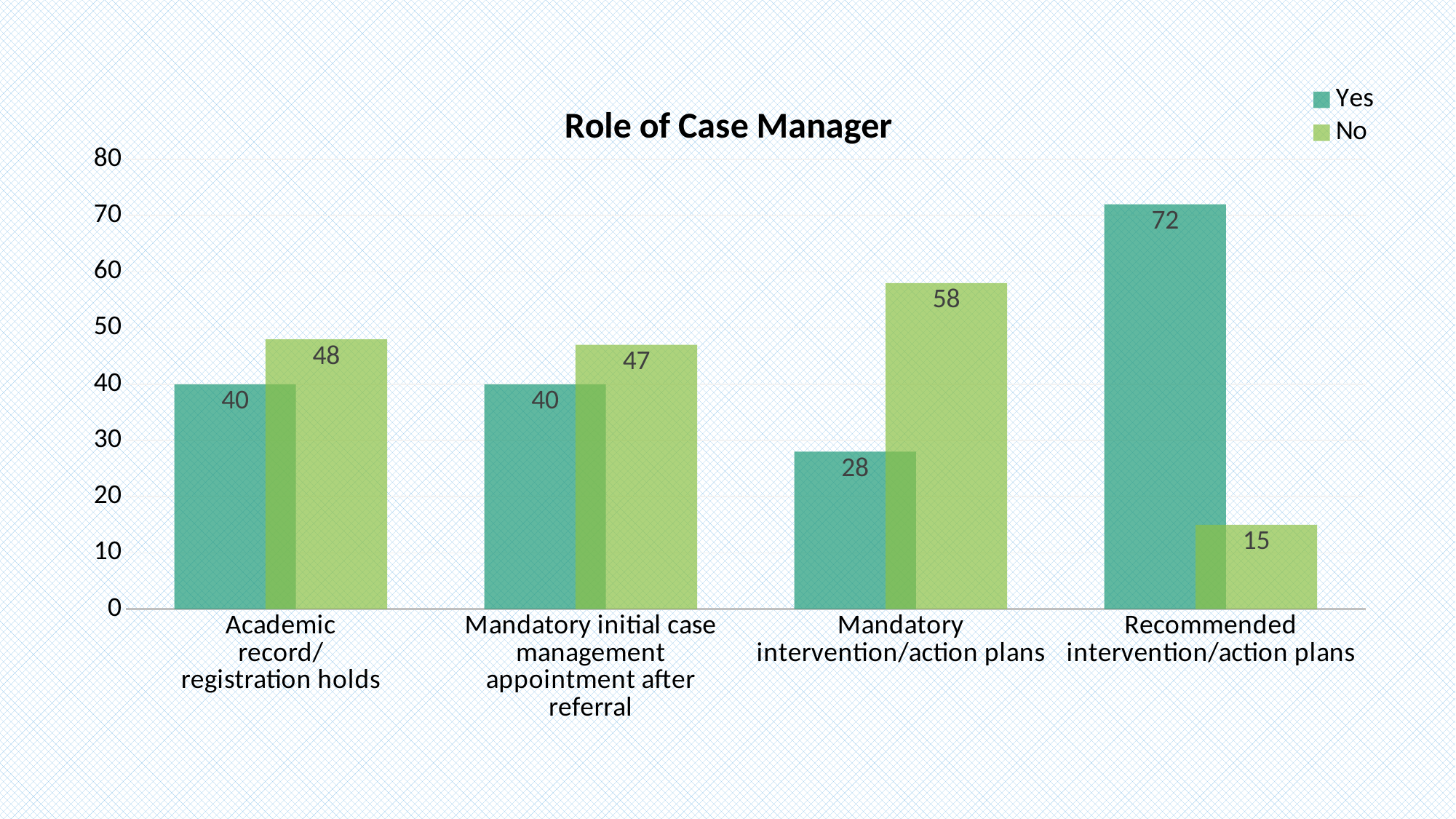
What is the title of the chart? Role of Case Manager What is the No value for Mandatory intervention/action plans? 58 Which category has the lowest No value? Recommended intervention/action plans How many categories are shown on the x axis? 4 What is the No value for Academic record/registration holds? 48 For Mandatory intervention/action plans, which is larger, the Yes value or the No value? No What kind of chart is shown on the slide? Bar chart What is the difference between the Yes and No values for Recommended intervention/action plans? 57 What is the Yes value for Recommended intervention/action plans? 72 What is the Yes value for Mandatory initial case management appointment after referral? 40 Which category has the highest Yes value? Recommended intervention/action plans How many series does the legend list? 2